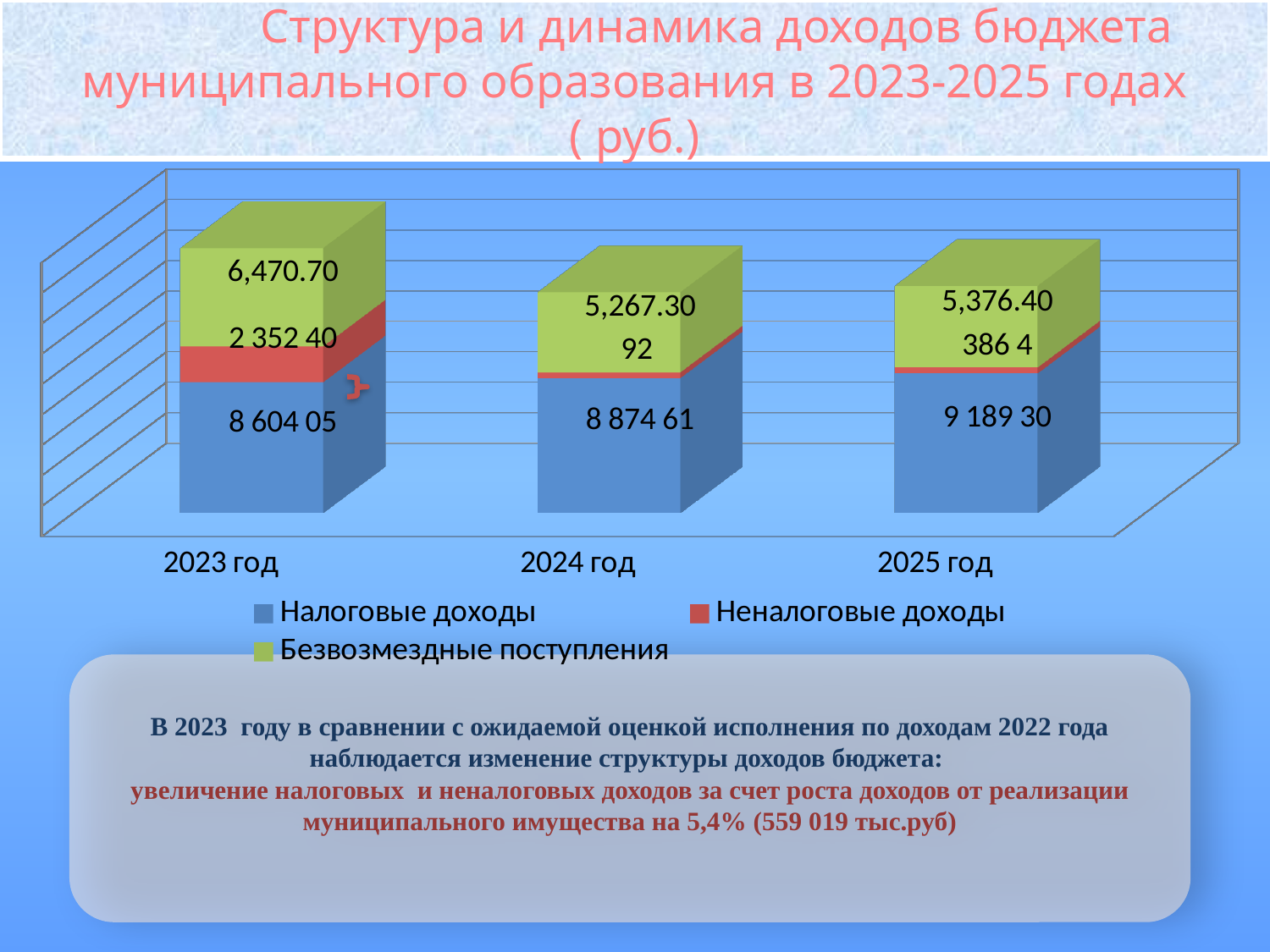
In which year is Безвозмездные поступления lowest? 2024 год What is the data label shown for Налоговые доходы in 2025 год? 9 189 30 What kind of chart is shown on the slide? Stacked bar chart How many series does the legend list? 3 What is the difference in Безвозмездные поступления between 2023 год and 2024 год? 1,203.40 How many years are shown on the x axis? 3 What is the value of Безвозмездные поступления for 2025 год? 5,376.40 In which year is Безвозмездные поступления highest? 2023 год What is the value of Безвозмездные поступления for 2023 год? 6,470.70 Which year has the larger Налоговые доходы segment, 2023 год or 2025 год? 2025 год What is the data label shown for Налоговые доходы in 2024 год? 8 874 61 What is the value of Безвозмездные поступления for 2024 год? 5,267.30